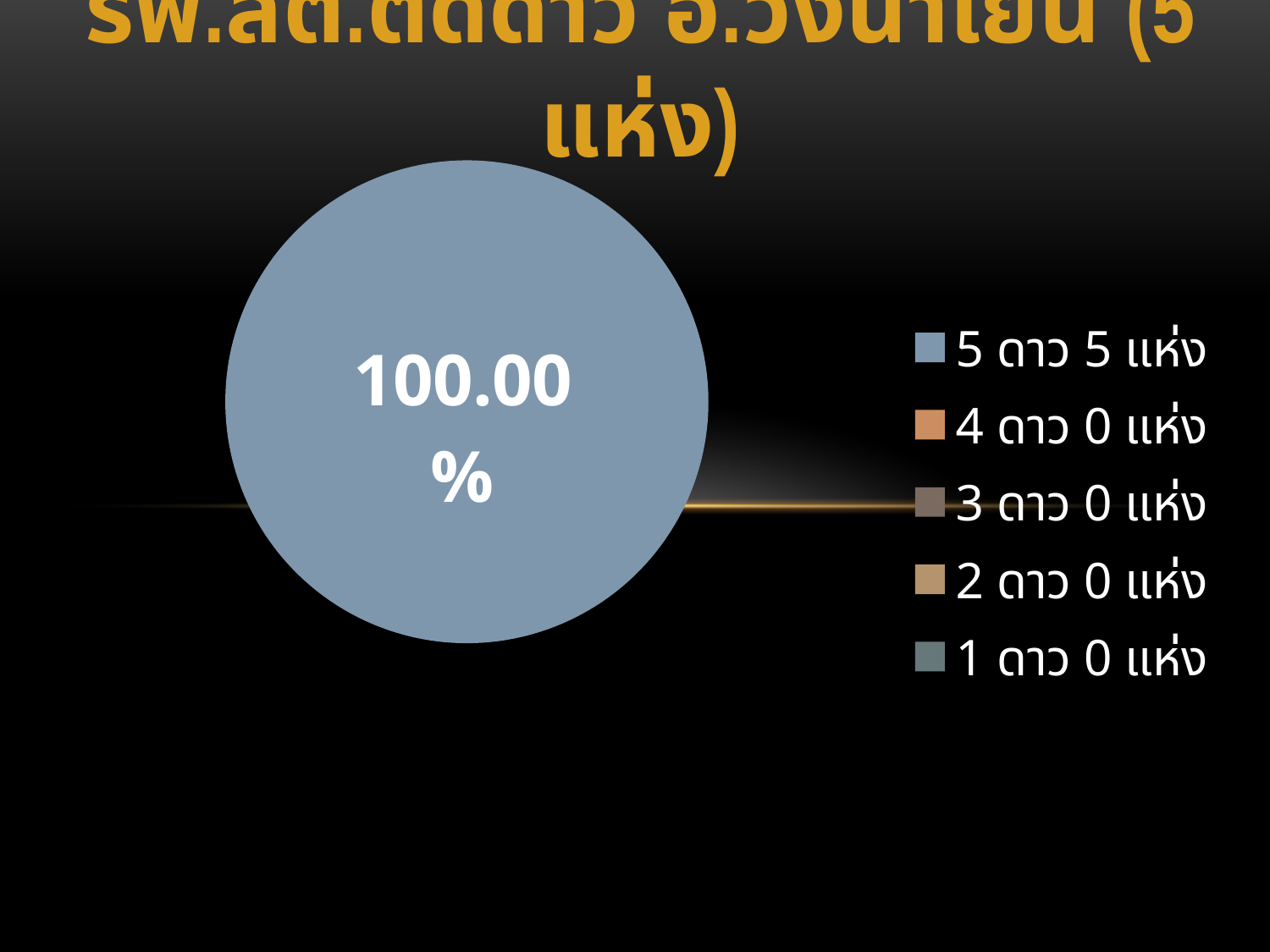
According to the legend, how many แห่ง are in the 1 ดาว category? 0 What is the difference between the number of แห่ง for 5 ดาว and for 2 ดาว? 5 What is the first entry listed in the pie chart's legend? 5 ดาว 5 แห่ง What percentage is printed on the pie chart's only visible slice? 100.00% How many legend categories have a count of 0 แห่ง? 4 According to the legend, how many แห่ง are in the 4 ดาว category? 0 Which category makes up the entire pie chart? 5 ดาว 5 แห่ง According to the legend, how many แห่ง are in the 5 ดาว category? 5 Which is larger, the number of แห่ง for 5 ดาว or for 3 ดาว? 5 ดาว What kind of chart is shown on the slide? pie chart What share of the pie does the 5 ดาว category account for? 100.00% How many categories does the legend of the pie chart list? 5